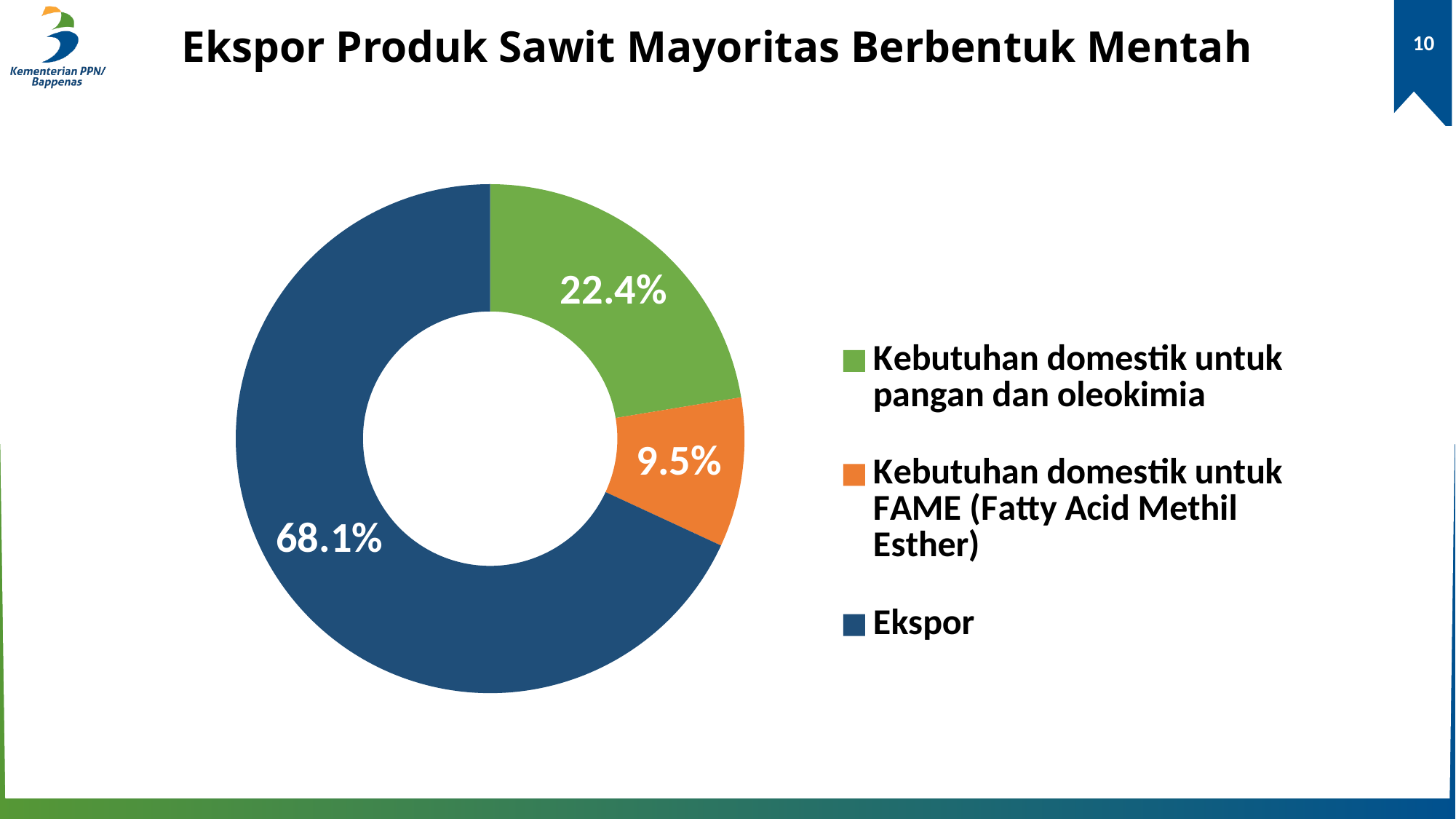
Which is larger: the slice for Kebutuhan domestik untuk pangan dan oleokimia or the slice for Kebutuhan domestik untuk FAME (Fatty Acid Methil Esther)? Kebutuhan domestik untuk pangan dan oleokimia What share of the pie is labelled for Ekspor? 68.1% What is the combined share of the two Kebutuhan domestik slices? 31.9% How many slices does the pie chart have? 3 Which category has the largest slice of the pie? Ekspor What is the difference in percentage points between the Kebutuhan domestik untuk pangan dan oleokimia slice and the Kebutuhan domestik untuk FAME (Fatty Acid Methil Esther) slice? 12.9 What kind of chart is shown on the slide? Doughnut chart What is the difference in percentage points between the Ekspor slice and the Kebutuhan domestik untuk pangan dan oleokimia slice? 45.7 Which category has the smallest slice of the pie? Kebutuhan domestik untuk FAME (Fatty Acid Methil Esther) What share of the pie is labelled for Kebutuhan domestik untuk FAME (Fatty Acid Methil Esther)? 9.5% What colour is the Ekspor slice in the pie chart? Dark blue What share of the pie is labelled for Kebutuhan domestik untuk pangan dan oleokimia? 22.4%